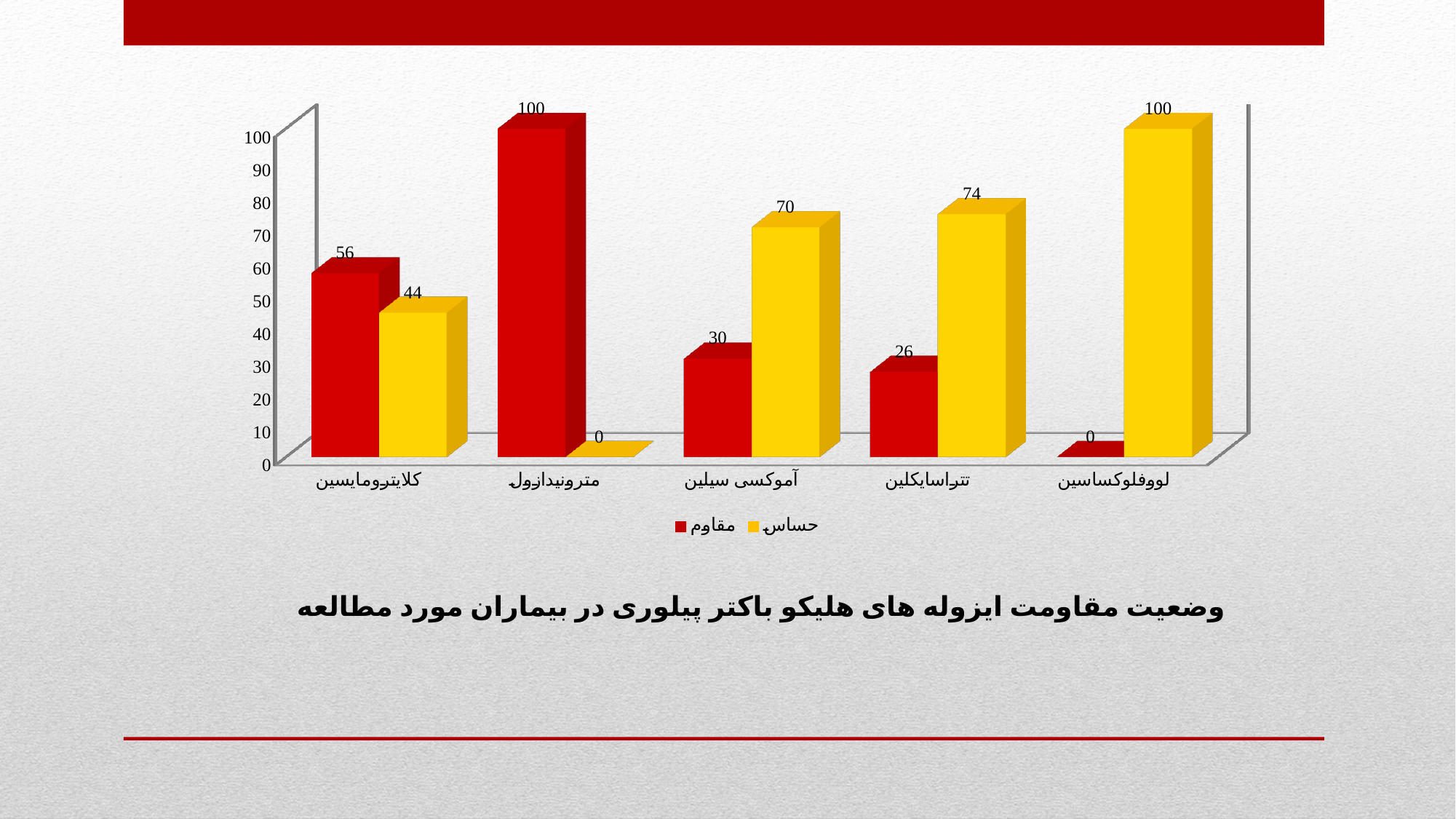
What is the value of the حساس (yellow) bar for مترونیدازول? 0 How many series does the chart legend list? 2 Which category has the lowest حساس (yellow) value? مترونیدازول Which colour represents the مقاوم series in the chart? Red What kind of chart is shown on the slide? Bar chart For تتراسایکلین, which is larger: the مقاوم value or the حساس value? حساس What is the difference between the مقاوم and حساس values for کلاریترومایسین? 12 What is the value of the مقاوم (red) bar for تتراسایکلین? 26 What is the value of the مقاوم (red) bar for کلاریترومایسین? 56 What is the value of the حساس (yellow) bar for آموکسی سیلین? 70 Which category has the highest مقاوم (red) value? مترونیدازول How many categories are shown on the x axis of the chart? 5